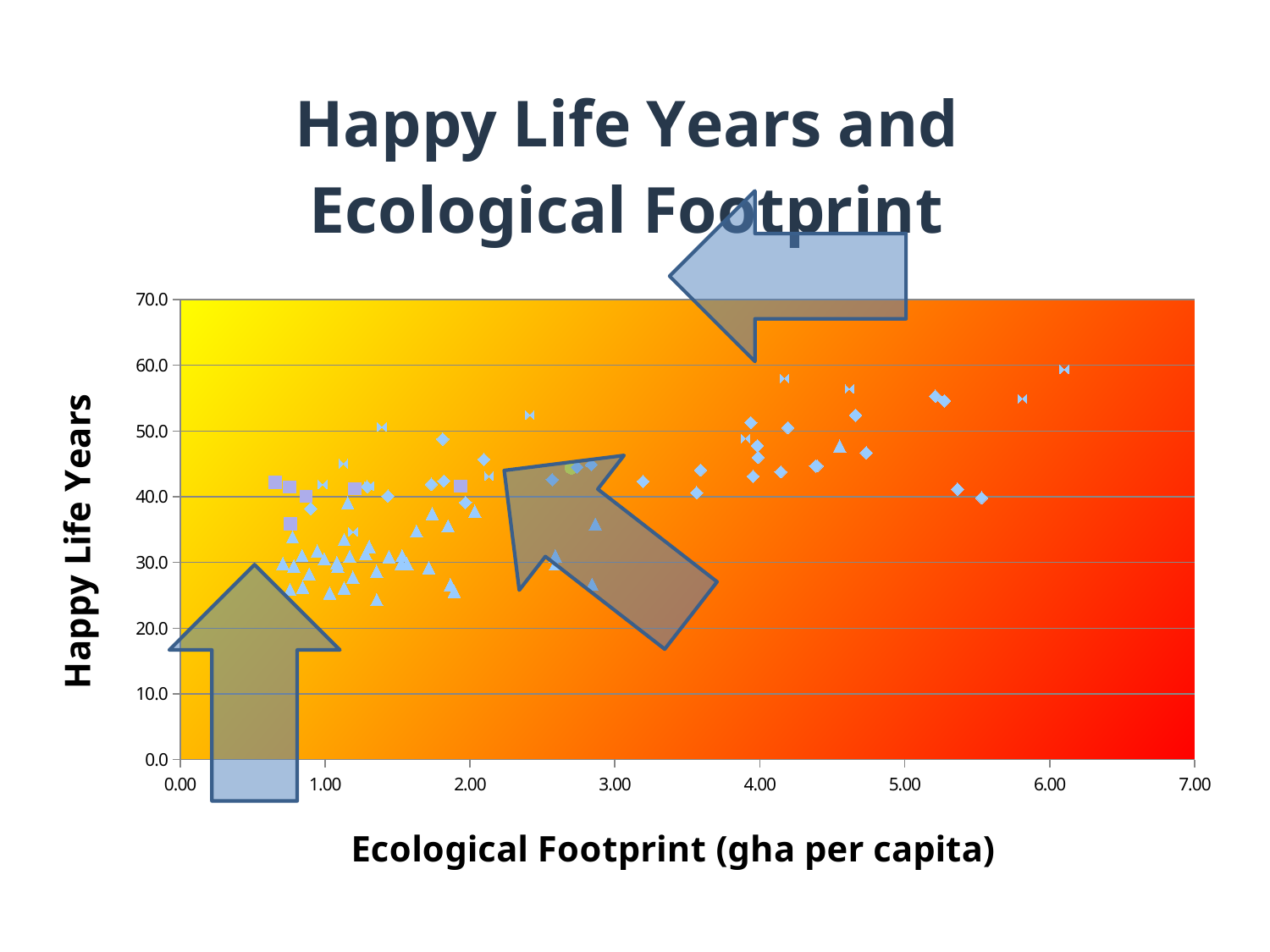
What is the label of the horizontal axis? Ecological Footprint (gha per capita) What is the title of the chart? Happy Life Years and Ecological Footprint Is the Happy Life Years value of the highest plotted point greater or less than 50? greater Is the Ecological Footprint of the rightmost plotted point greater or less than 6.00? greater Are the points with Ecological Footprint below 1.00 mostly above or below 50 Happy Life Years? below Do Happy Life Years generally rise or fall as Ecological Footprint increases along the x axis? rise What kind of chart is shown on the slide? scatter chart